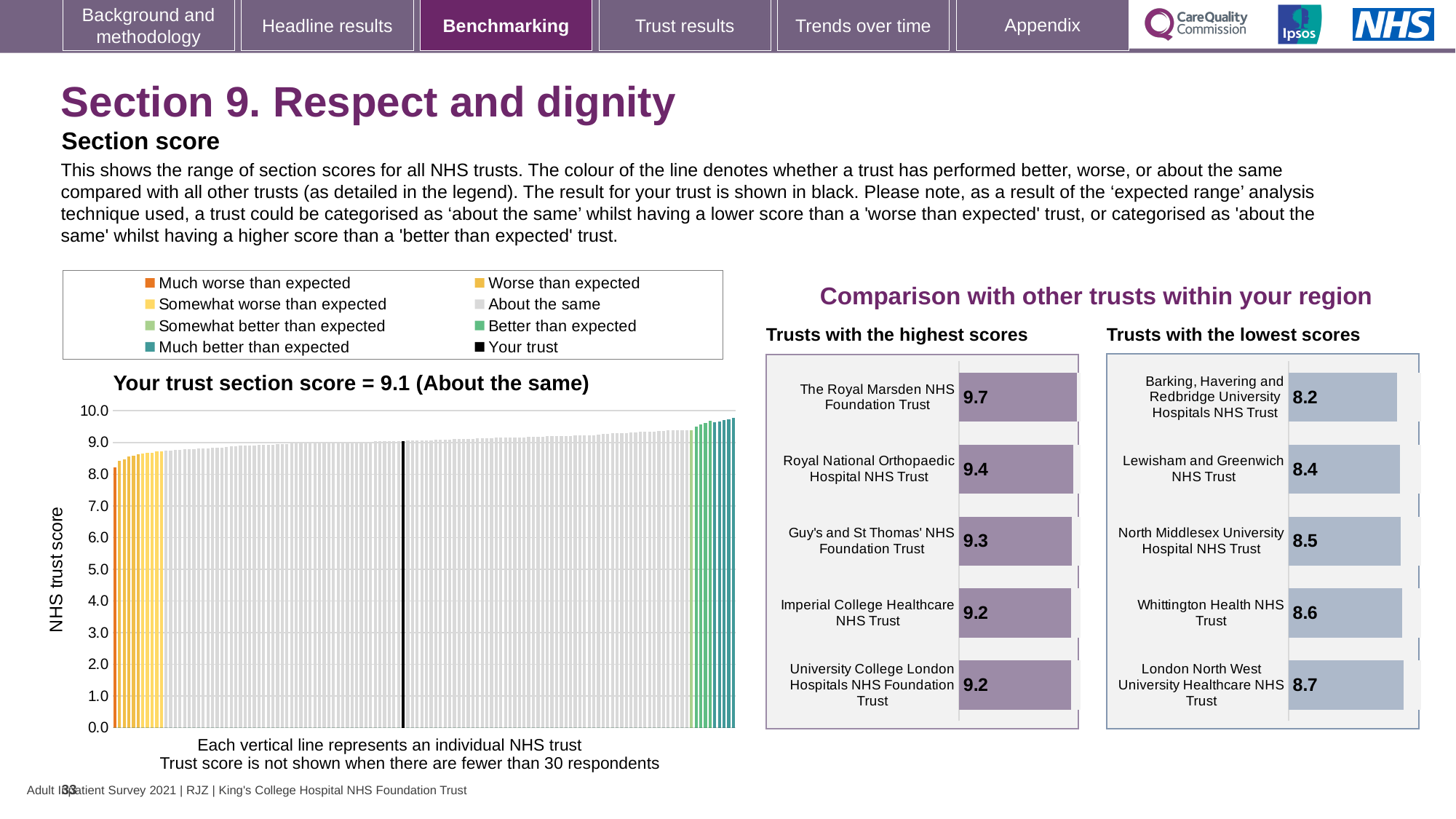
In the 'Trusts with the highest scores' chart, what is the difference between the scores of The Royal Marsden NHS Foundation Trust and Royal National Orthopaedic Hospital NHS Trust? 0.3 In the 'Trusts with the lowest scores' chart, which trust has the lowest score? Barking, Havering and Redbridge University Hospitals NHS Trust In the 'Trusts with the lowest scores' chart, what is the difference between the scores of London North West University Healthcare NHS Trust and Barking, Havering and Redbridge University Hospitals NHS Trust? 0.5 How many entries does the legend above the 'Your trust section score' chart list? 8 In the 'Trusts with the lowest scores' chart, what is the score for Whittington Health NHS Trust? 8.6 In the 'Your trust section score' chart, what is the section score for your trust? 9.1 In the 'Your trust section score' chart, do the trust scores rise or fall from left to right along the x axis? rise In the 'Trusts with the lowest scores' chart, which has the higher score: Lewisham and Greenwich NHS Trust or North Middlesex University Hospital NHS Trust? North Middlesex University Hospital NHS Trust In the 'Trusts with the highest scores' chart, what is the score for Guy's and St Thomas' NHS Foundation Trust? 9.3 How many trusts are shown in the 'Trusts with the highest scores' chart? 5 In the 'Trusts with the highest scores' chart, which trust has the highest score? The Royal Marsden NHS Foundation Trust In the 'Trusts with the highest scores' chart, what is the score for The Royal Marsden NHS Foundation Trust? 9.7